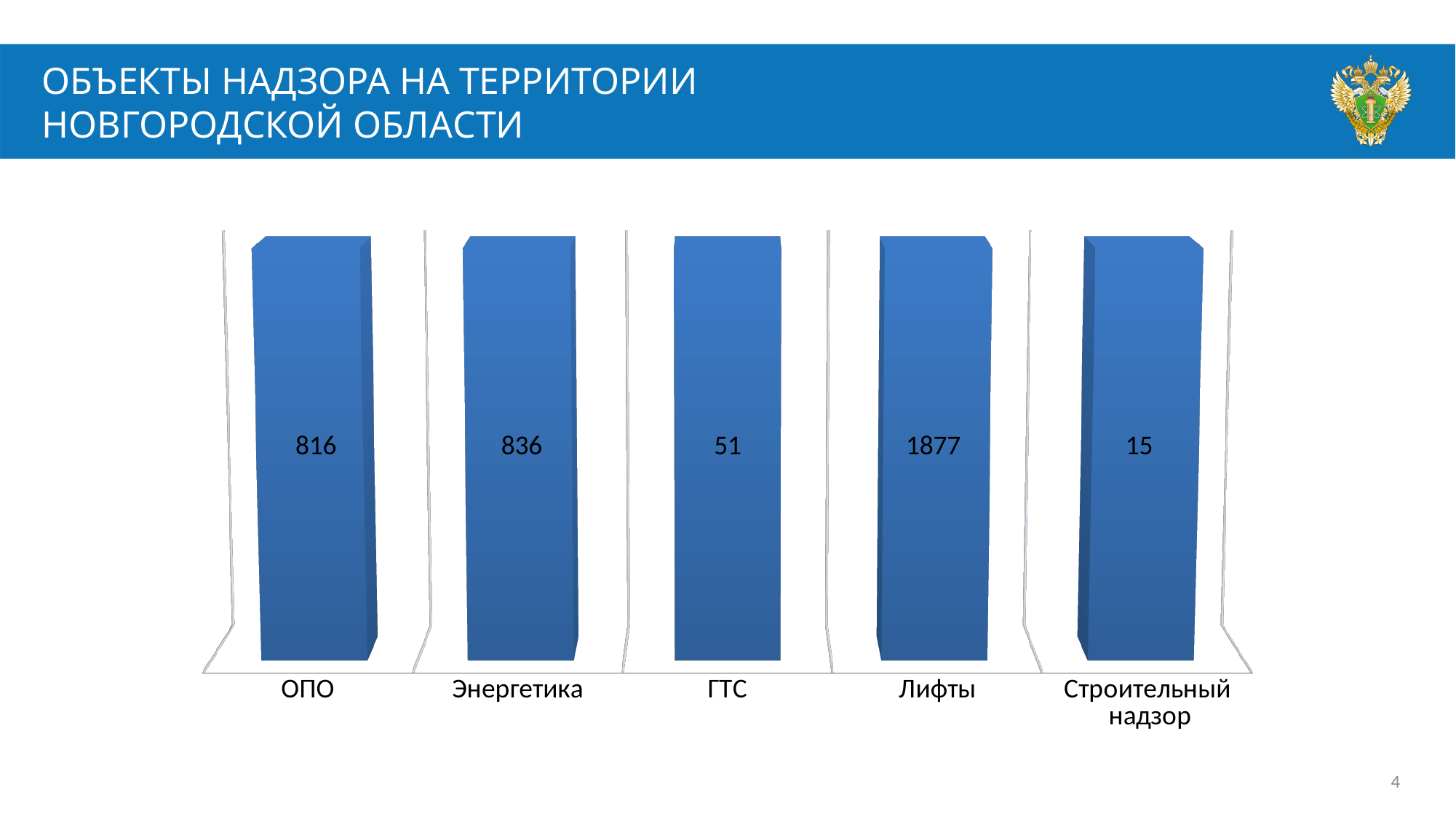
Which has a larger value, ГТС or Строительный надзор? ГТС Which category has the highest value according to the data labels? Лифты What is the difference between the values for Энергетика and ОПО? 20 What is the value for Лифты? 1877 What is the value for ОПО? 816 What is the difference between the values for Лифты and ГТС? 1826 What kind of chart is shown on the slide? Bar chart How many categories are shown in the chart? 5 Which category has the lowest value according to the data labels? Строительный надзор What is the value for Энергетика? 836 What is the value for ГТС? 51 What is the value for Строительный надзор? 15